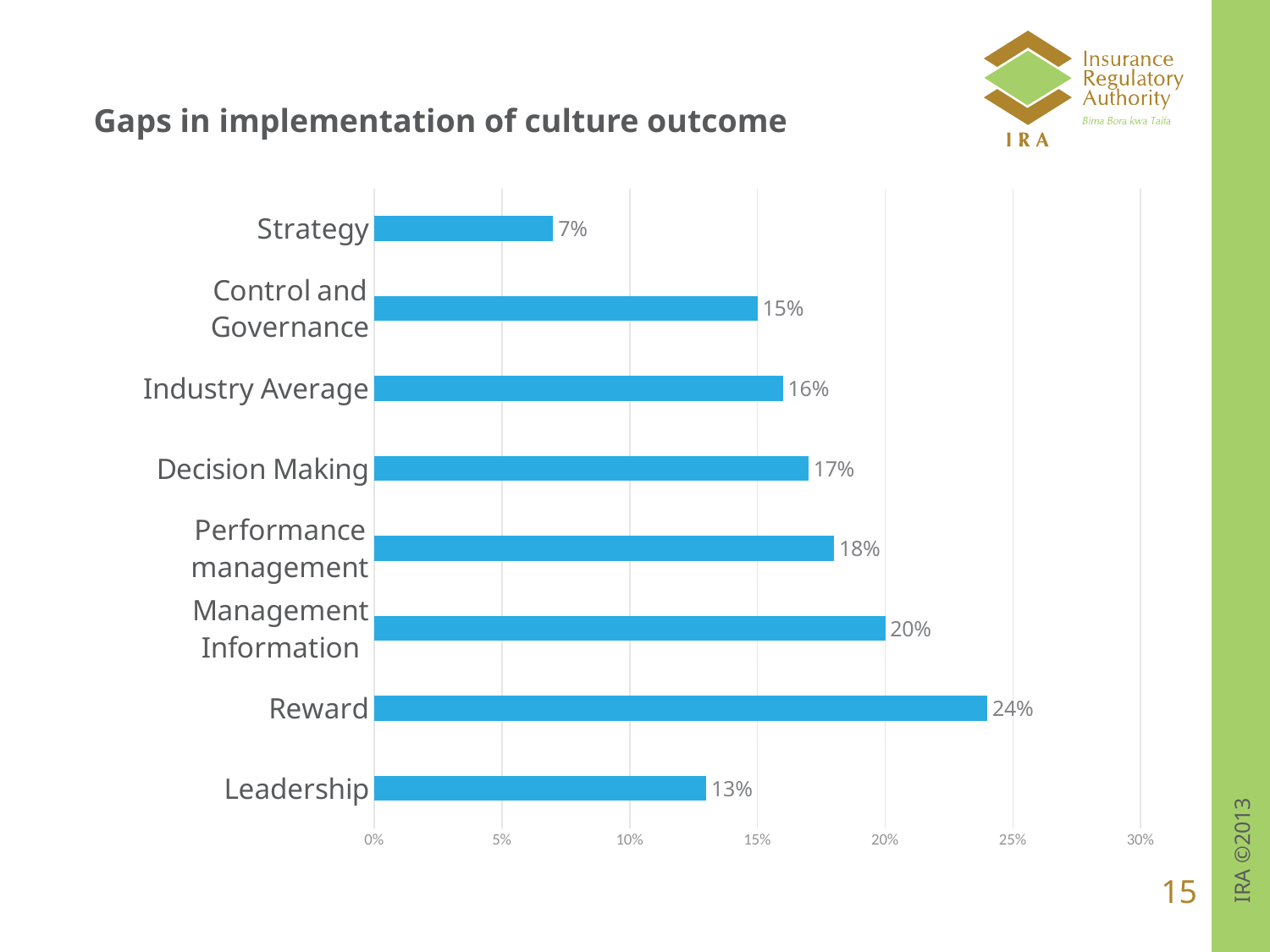
What is the value for Leadership? 13% How many categories are shown in the chart? 8 What is the difference between the values for Industry Average and Strategy? 9% Which category has the lowest value? Strategy Which is larger, the value for Decision Making or the value for Control and Governance? Decision Making What kind of chart is shown on the slide? Bar chart What is the difference between the values for Reward and Leadership? 11% Which category has the highest value? Reward What is the value for Strategy? 7% What is the value for Management Information? 20% What is the value for Reward? 24% Is the value for Performance management greater or less than 15%? greater